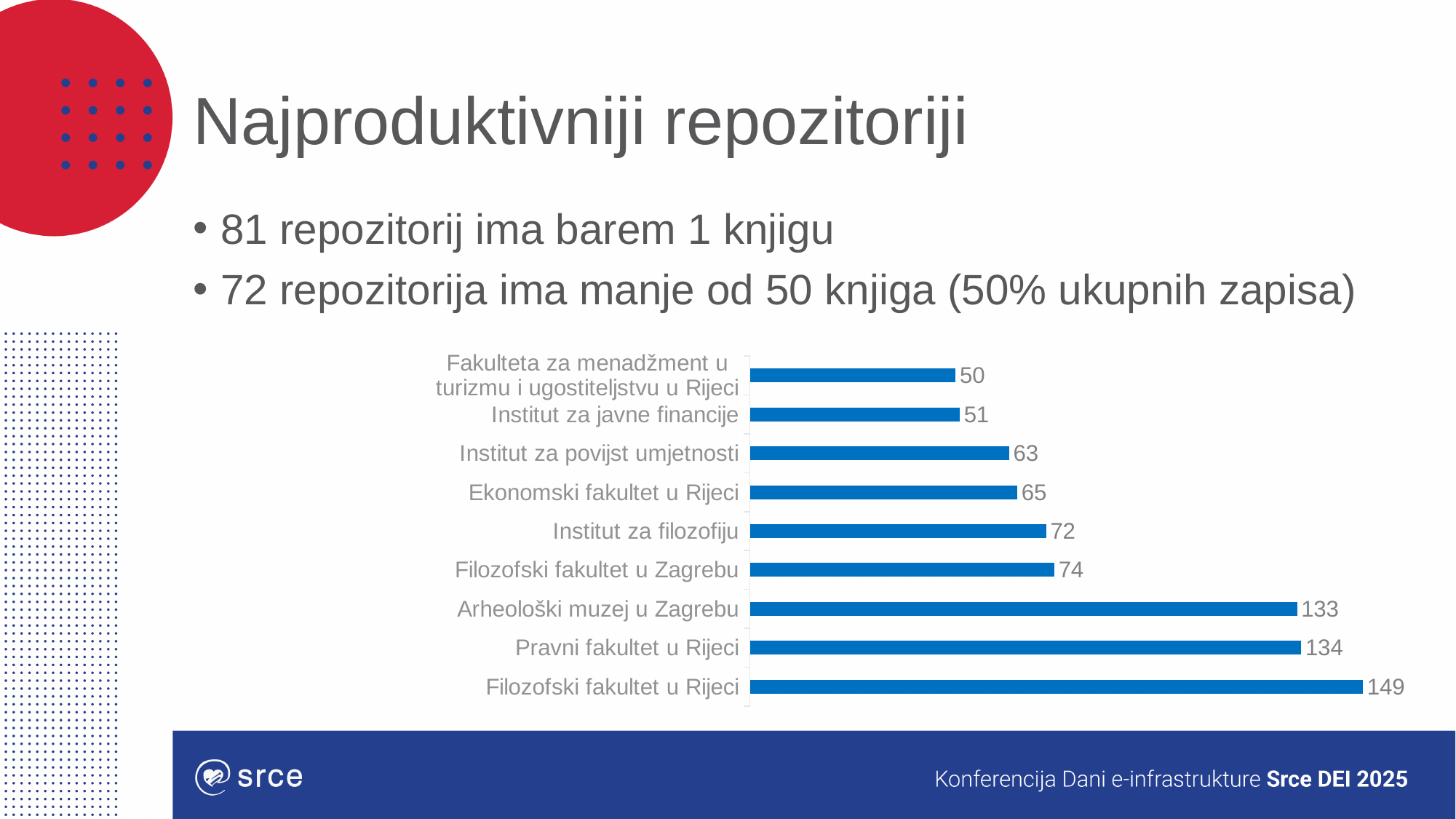
What value is shown for Institut za filozofiju? 72 Which is larger, the value for Arheološki muzej u Zagrebu or the value for Filozofski fakultet u Zagrebu? Arheološki muzej u Zagrebu How many categories are shown in the chart? 9 What colour are the bars in the chart? Blue What value is shown for Institut za javne financije? 51 What is the difference between the values for Filozofski fakultet u Rijeci and Pravni fakultet u Rijeci? 15 What value is shown for Arheološki muzej u Zagrebu? 133 What value is shown for Filozofski fakultet u Rijeci? 149 Which category has the highest value? Filozofski fakultet u Rijeci What kind of chart is shown on the slide? Bar chart Which category has the lowest value? Fakulteta za menadžment u turizmu i ugostiteljstvu u Rijeci What is the difference between the values for Filozofski fakultet u Zagrebu and Ekonomski fakultet u Rijeci? 9